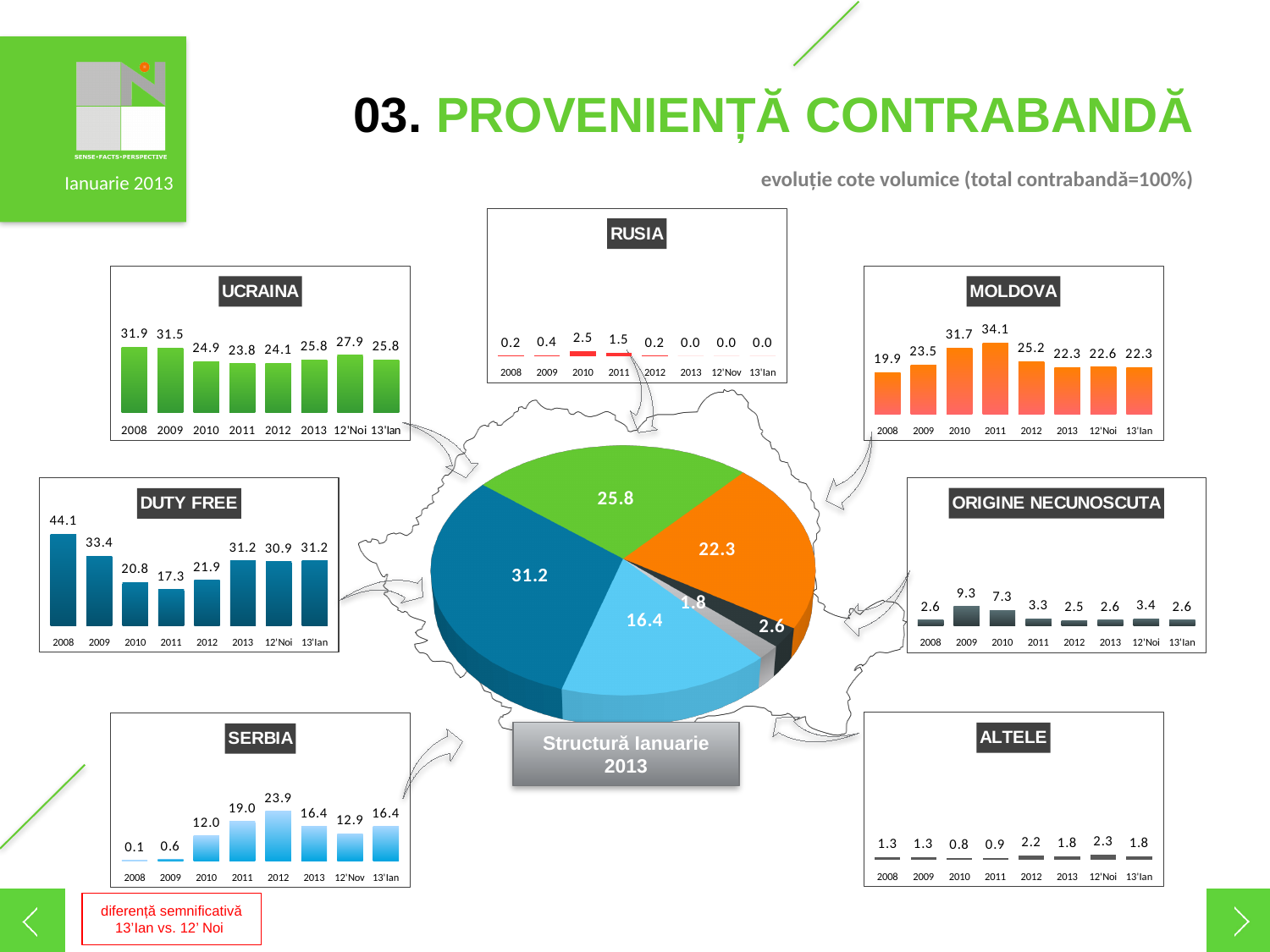
In the SERBIA chart, do the values rise or fall from 2008 to 2012? rise In the MOLDOVA chart, which year has the highest value? 2011 In the ORIGINE NECUNOSCUTA chart, which year has the highest value? 2009 In the DUTY FREE chart, what is the difference between the 2008 value and the 2011 value? 26.8 In the MOLDOVA chart, what is the value for 13'Ian? 22.3 In the RUSIA chart, what is the value for 2010? 2.5 In the SERBIA chart, which is larger, the value for 2012 or the value for 2011? 2012 In the UCRAINA chart, what is the value for 2008? 31.9 How many bars are in the SERBIA chart? 8 What kind of chart is the central 'Structură Ianuarie 2013' chart? pie chart In the ALTELE chart, which year has the lowest value? 2010 In the central pie chart, what is the value of the largest slice? 31.2